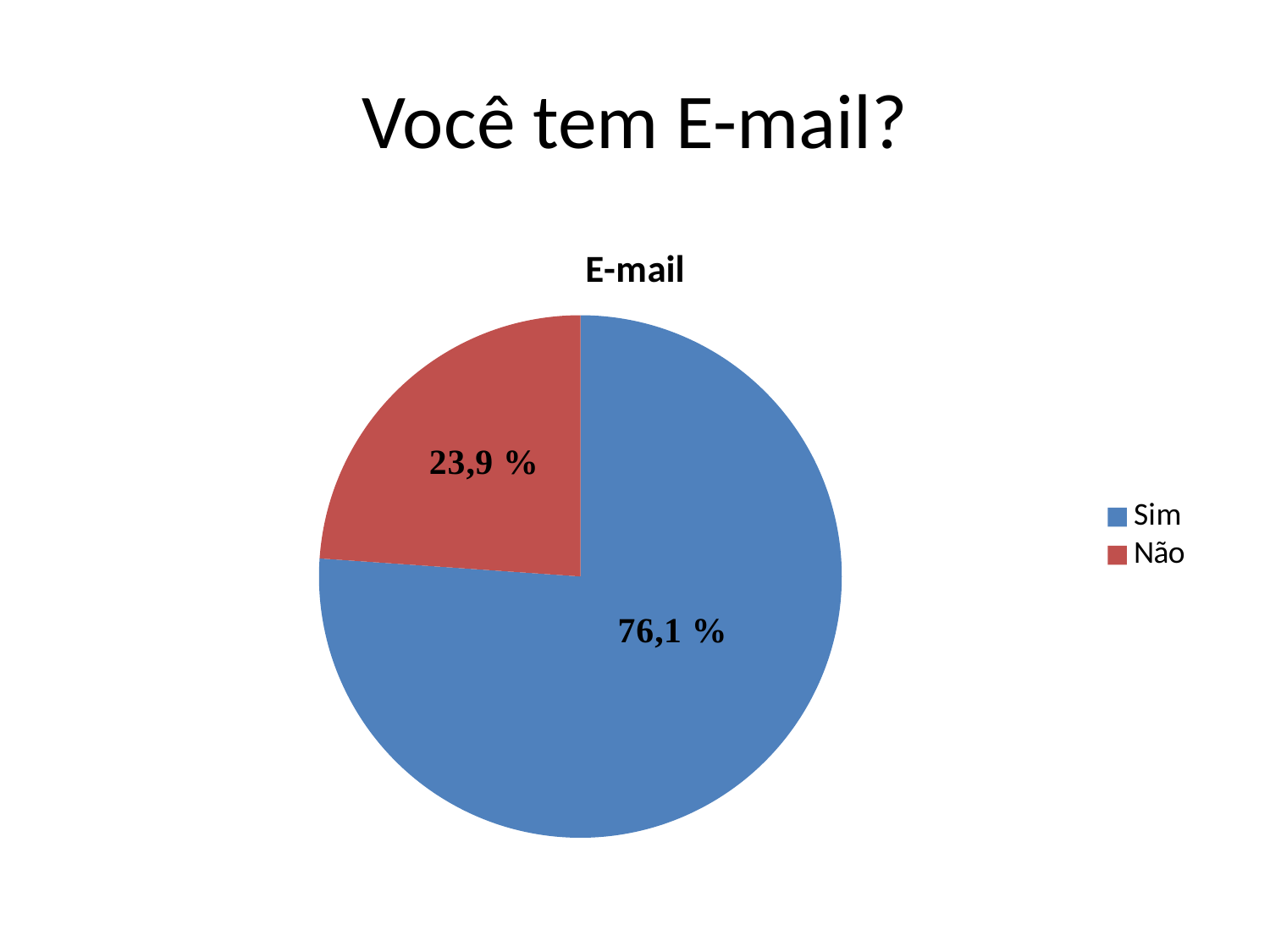
What share of the pie does Não have? 23,9 % What colour is the Não slice? red What kind of chart is shown on the slide? pie chart How many entries does the legend list? 2 How many slices does the pie chart have? 2 What is the difference between the Sim and Não shares? 52,2 % Which is larger, Sim or Não? Sim Which slice is the smallest? Não What is the chart's title? E-mail What share of the pie does Sim have? 76,1 % Which slice is the largest? Sim